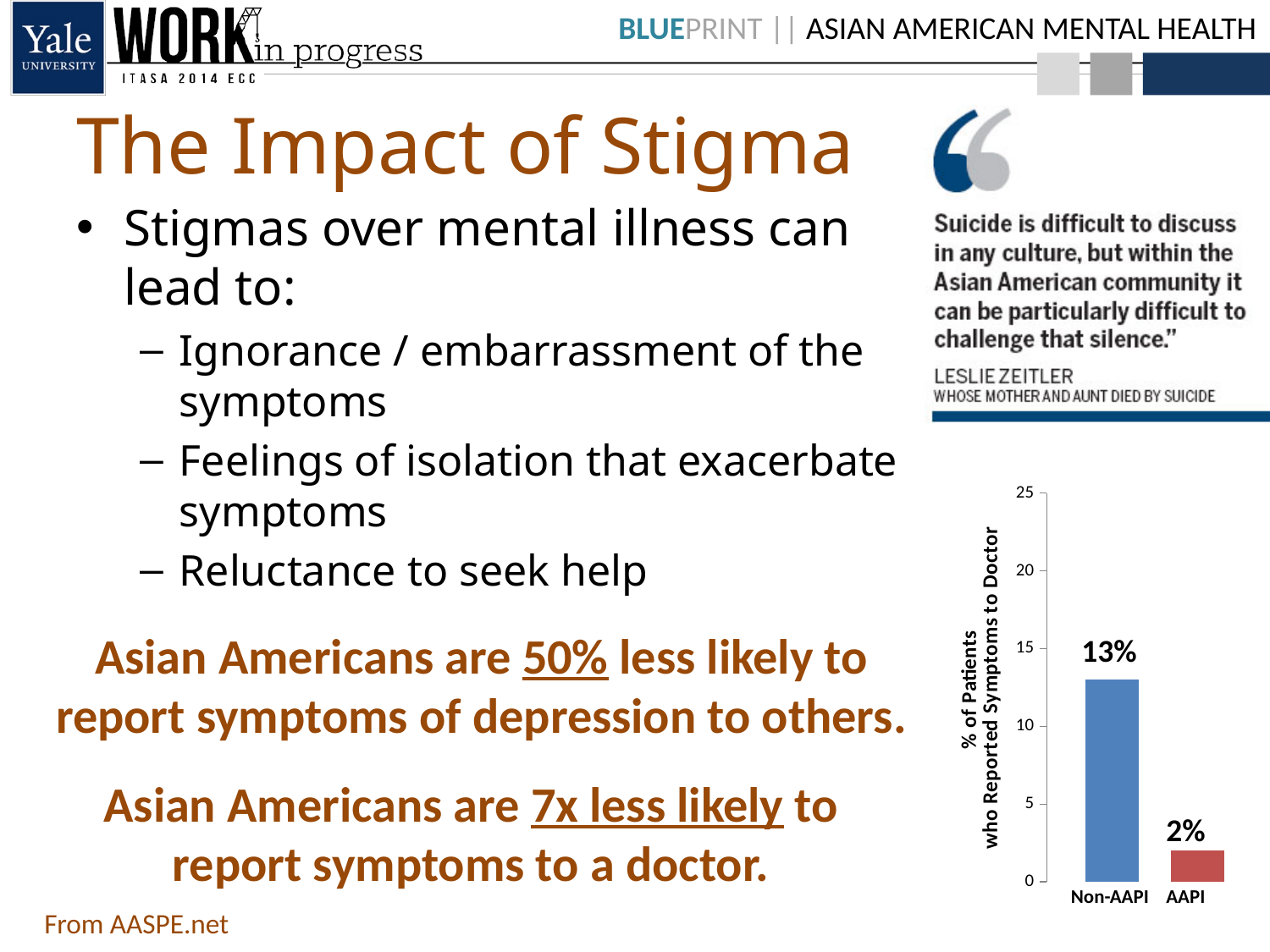
Is the value for Non-AAPI greater or less than 10? greater What is the difference between the Non-AAPI and AAPI values in the bar chart? 11% What kind of chart is shown on the slide? bar chart What is the maximum value shown on the vertical axis of the bar chart? 25 What is the value for AAPI in the bar chart? 2% Which is larger in the bar chart, the value for Non-AAPI or the value for AAPI? Non-AAPI Which category has the highest value in the bar chart? Non-AAPI Is the value for AAPI greater or less than 5? less What is the value for Non-AAPI in the bar chart? 13% How many categories are shown in the bar chart? 2 What is the label of the vertical axis of the bar chart? % of Patients who Reported Symptoms to Doctor Which category has the lowest value in the bar chart? AAPI